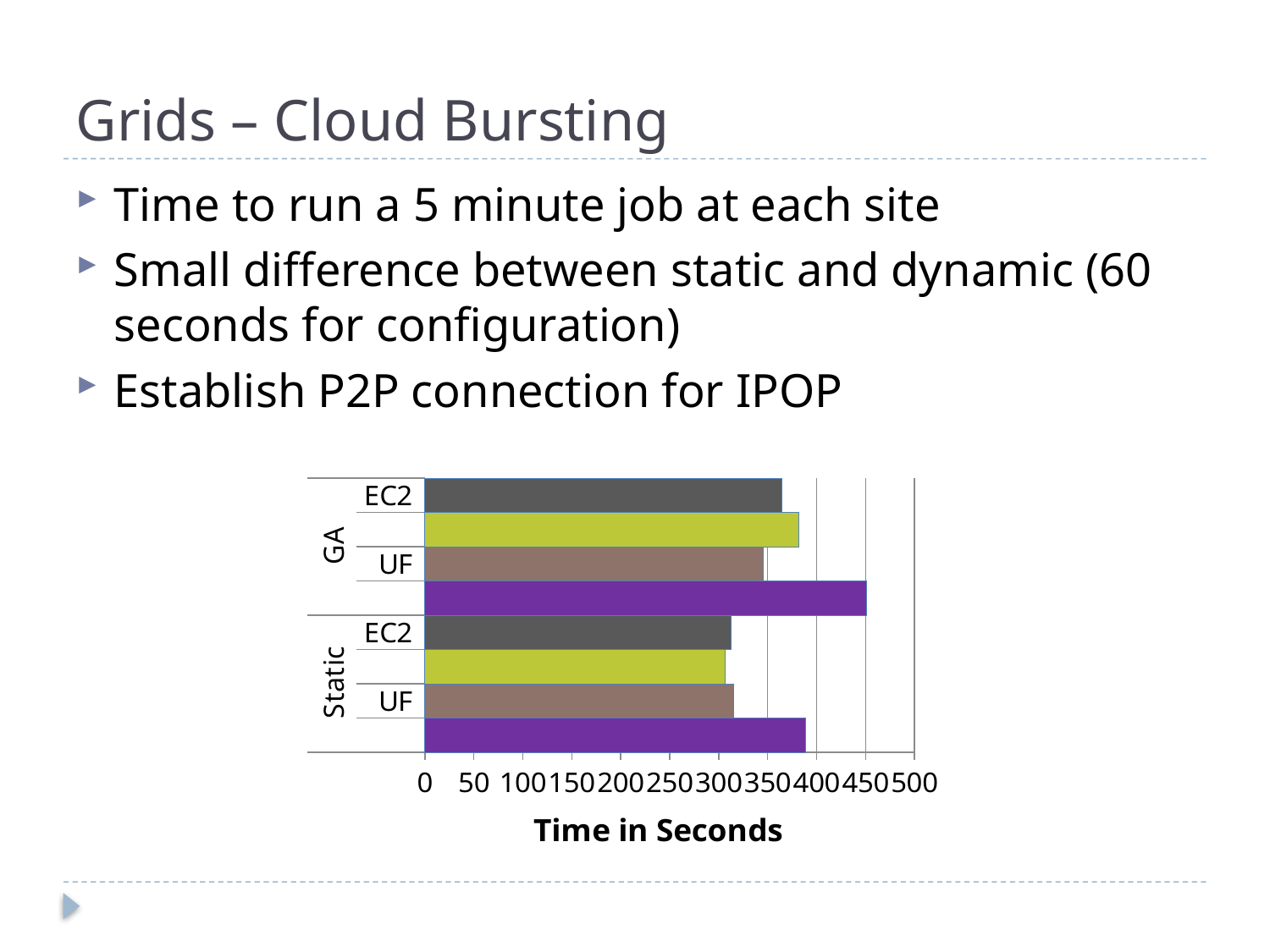
Which group, GA or Static, contains the longest bar in the chart? GA Is the value for UF in the Static group greater or less than 250? greater Is the value for EC2 in the Static group greater or less than 350? less What kind of chart is shown on the slide? bar chart Is the value for EC2 in the GA group greater or less than 300? greater What is the highest value shown on the horizontal axis of the chart? 500 What is the title of the horizontal axis of the chart? Time in Seconds What are the two groups of bars labelled on the vertical axis of the chart? GA and Static Which is larger, the EC2 value in the GA group or the EC2 value in the Static group? GA Which is larger, the UF value in the GA group or the UF value in the Static group? GA How many bars are plotted in each group (GA and Static) of the chart? 4